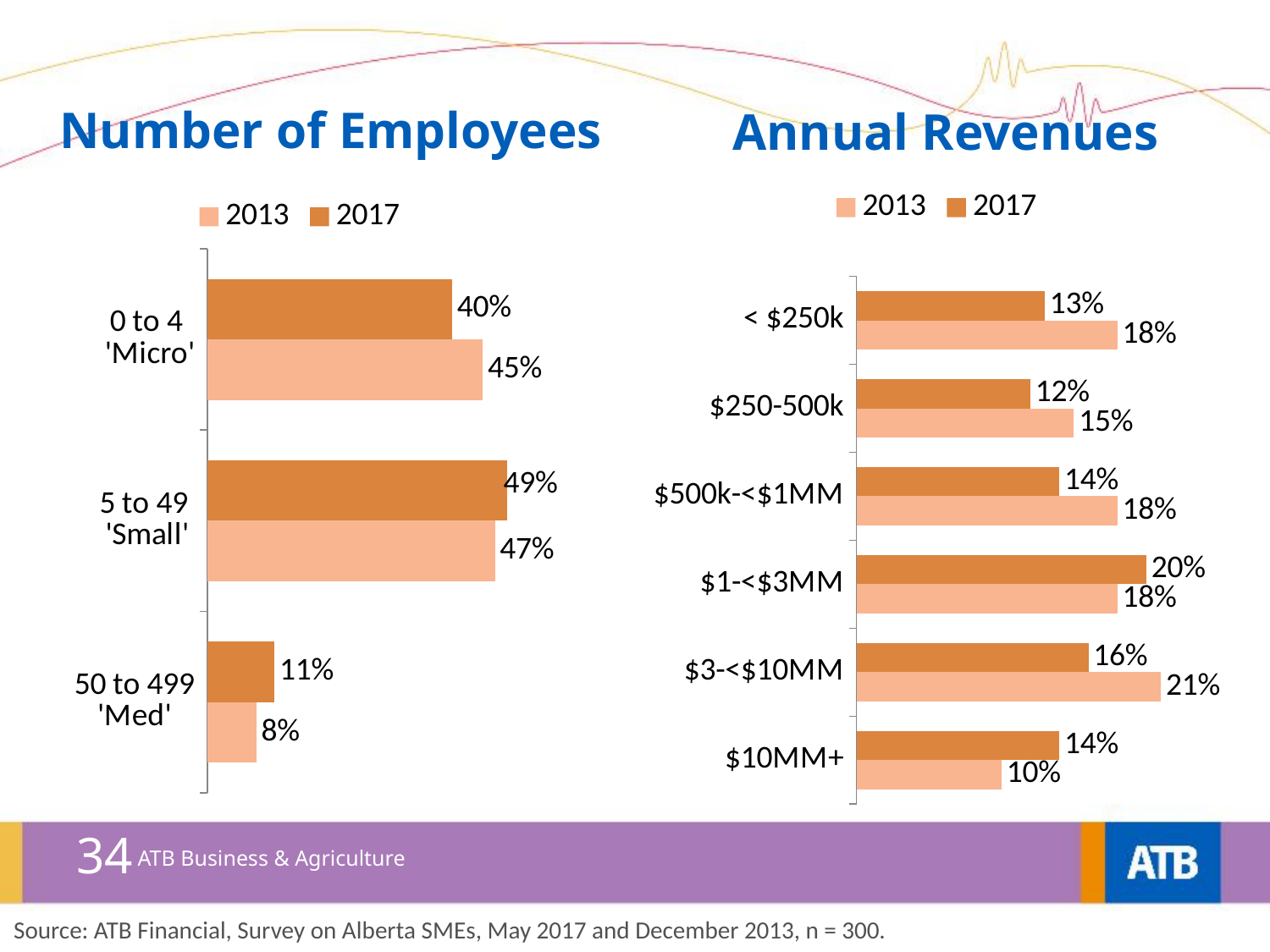
In the Annual Revenues chart, what is the 2017 value for $250-500k? 12% In the Number of Employees chart, what is the 2017 value for 5 to 49 'Small'? 49% What type of chart is the Annual Revenues chart? Bar chart In the Annual Revenues chart, what is the 2013 value for $3-<$10MM? 21% In the Annual Revenues chart, how many revenue categories are shown? 6 In the Number of Employees chart, what is the difference between the 2013 and 2017 values for 50 to 499 'Med'? 3% In the Number of Employees chart, which category has the lowest 2013 value? 50 to 499 'Med' In the Number of Employees chart, how many series does the legend list? 2 In the Annual Revenues chart, which category has the highest 2017 value? $1-<$3MM In the Number of Employees chart, what is the 2013 value for 0 to 4 'Micro'? 45% In the Annual Revenues chart, is the 2013 value for < $250k larger or the 2017 value? 2013 In the Annual Revenues chart, which category has the lowest 2013 value? $10MM+